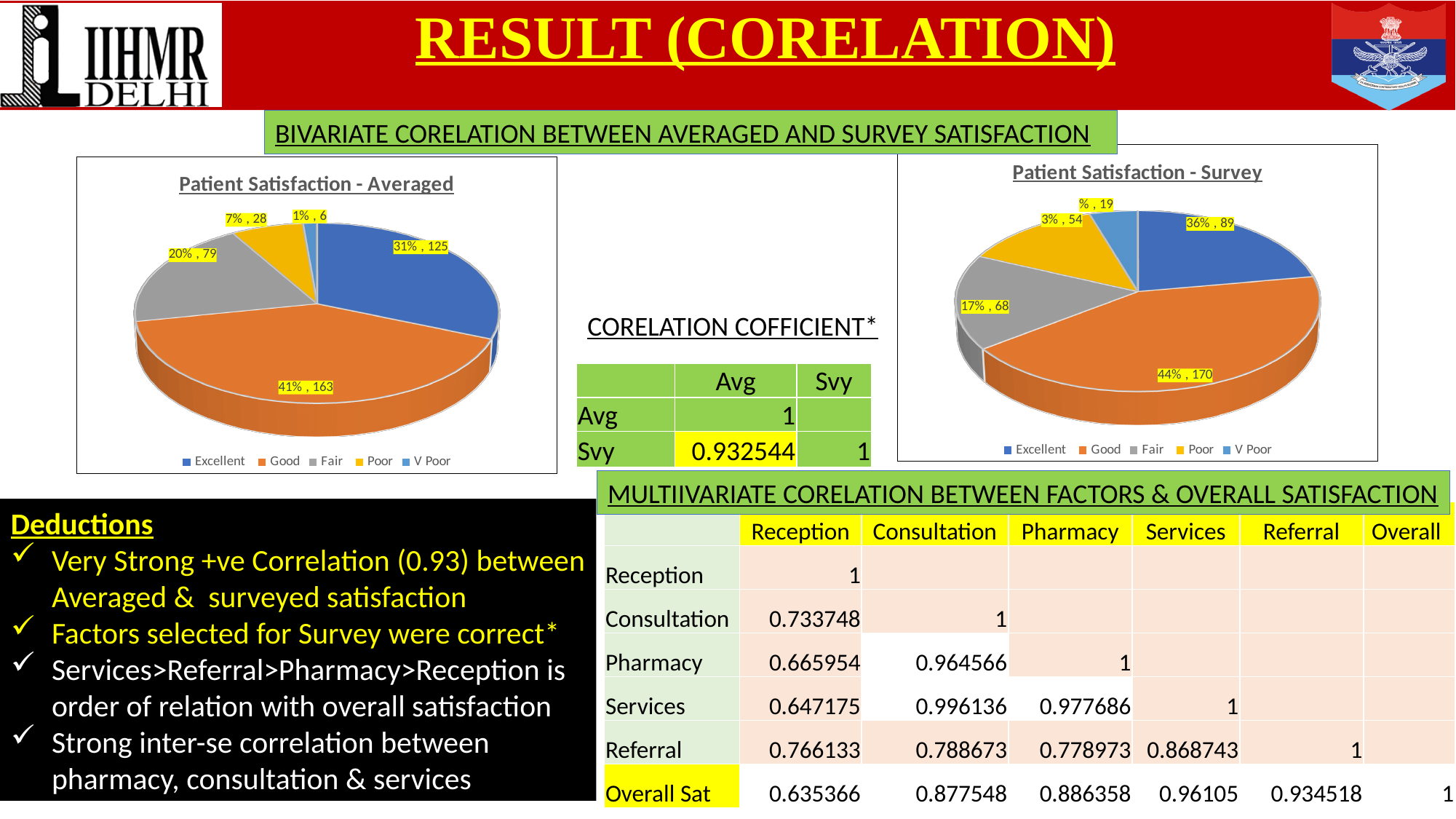
In the 'Patient Satisfaction - Survey' chart, what colour represents the Poor category? Yellow In the 'Patient Satisfaction - Averaged' chart, what percentage is shown for Excellent? 31% In the 'Patient Satisfaction - Averaged' chart, what is the difference between the counts for Good and Excellent? 38 How many categories does the legend of the 'Patient Satisfaction - Averaged' chart list? 5 In the 'Patient Satisfaction - Averaged' chart, which category has the largest slice? Good In the 'Patient Satisfaction - Survey' chart, which is larger, the Excellent slice or the Fair slice? Excellent In the 'Patient Satisfaction - Survey' chart, what percentage is shown for Fair? 17% In the 'Patient Satisfaction - Survey' chart, which category has the largest slice? Good In the 'Patient Satisfaction - Survey' chart, what value is shown for the Good slice? 44% , 170 What type of chart is 'Patient Satisfaction - Survey'? Pie chart In the 'Patient Satisfaction - Averaged' chart, what value is shown for the Good slice? 41% , 163 In the 'Patient Satisfaction - Averaged' chart, which category has the smallest slice? V Poor